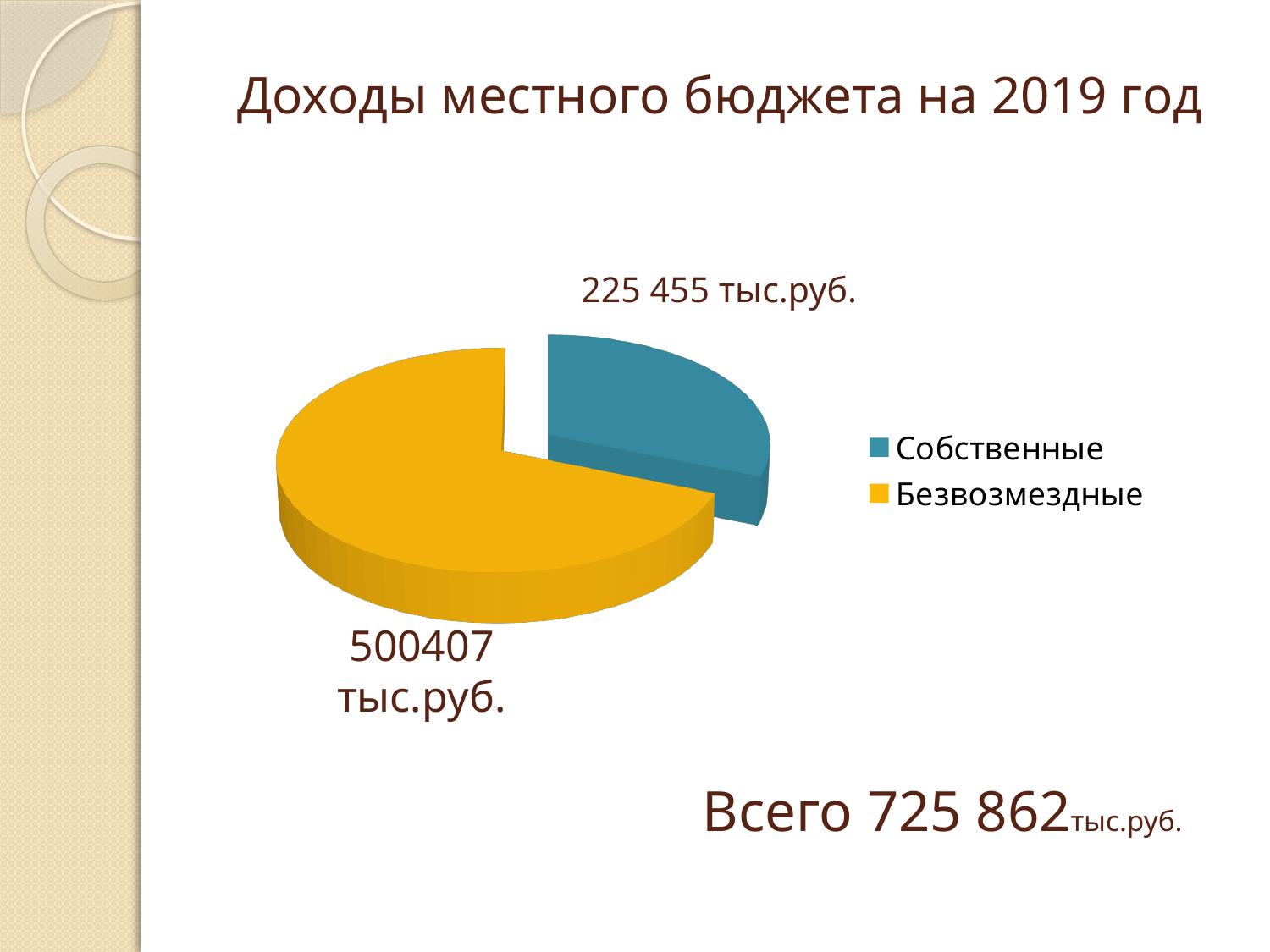
Which category has the largest slice of the pie? Безвозмездные What is the value for Безвозмездные? 500407 тыс.руб. Which category has the smallest slice of the pie? Собственные To the nearest whole percent, what share of the pie is Собственные? 31% How many entries does the legend list? 2 Which is larger, Собственные or Безвозмездные? Безвозмездные What type of chart is shown on the slide? pie chart What is the total of all slices, as stated on the slide? 725 862 тыс.руб. How many slices does the pie chart have? 2 What is the difference between Безвозмездные and Собственные, in тыс.руб.? 274952 What is the title of the slide? Доходы местного бюджета на 2019 год What is the value for Собственные? 225 455 тыс.руб.